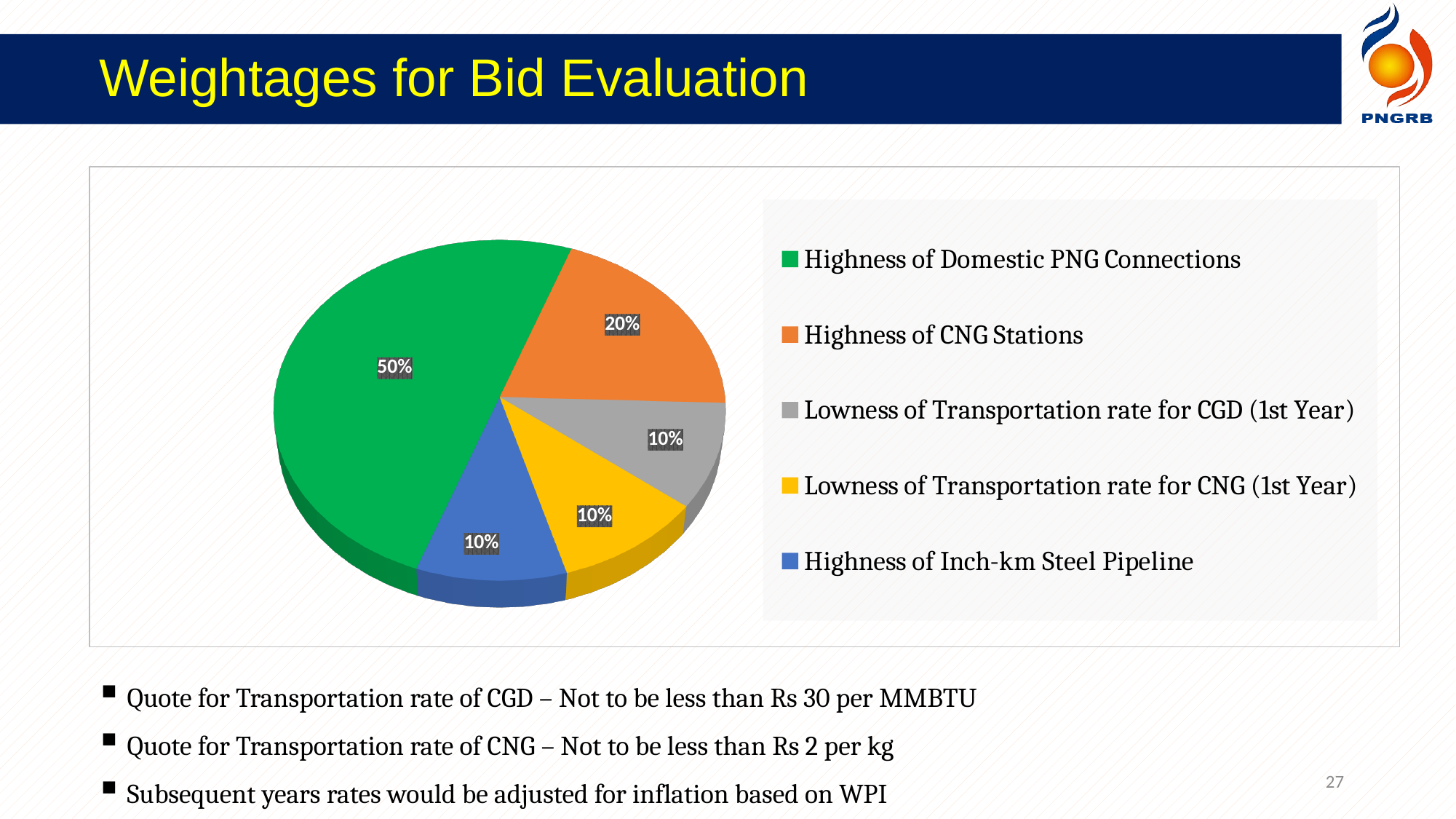
How many categories does the pie chart have? 5 Which is larger: the weightage for Highness of CNG Stations or for Lowness of Transportation rate for CNG (1st Year)? Highness of CNG Stations What is the combined weightage of Highness of Domestic PNG Connections and Highness of CNG Stations? 70% What is the weightage for Highness of Inch-km Steel Pipeline? 10% What is the weightage for Lowness of Transportation rate for CGD (1st Year)? 10% What is the weightage for Highness of Domestic PNG Connections? 50% What colour represents Highness of Inch-km Steel Pipeline in the pie chart? Blue Which category has the largest share of the pie? Highness of Domestic PNG Connections What is the difference between the weightage for Highness of Domestic PNG Connections and Highness of CNG Stations? 30% What is the weightage for Highness of CNG Stations? 20% What type of chart is shown on the slide? Pie chart How many categories have a weightage of 10%? 3